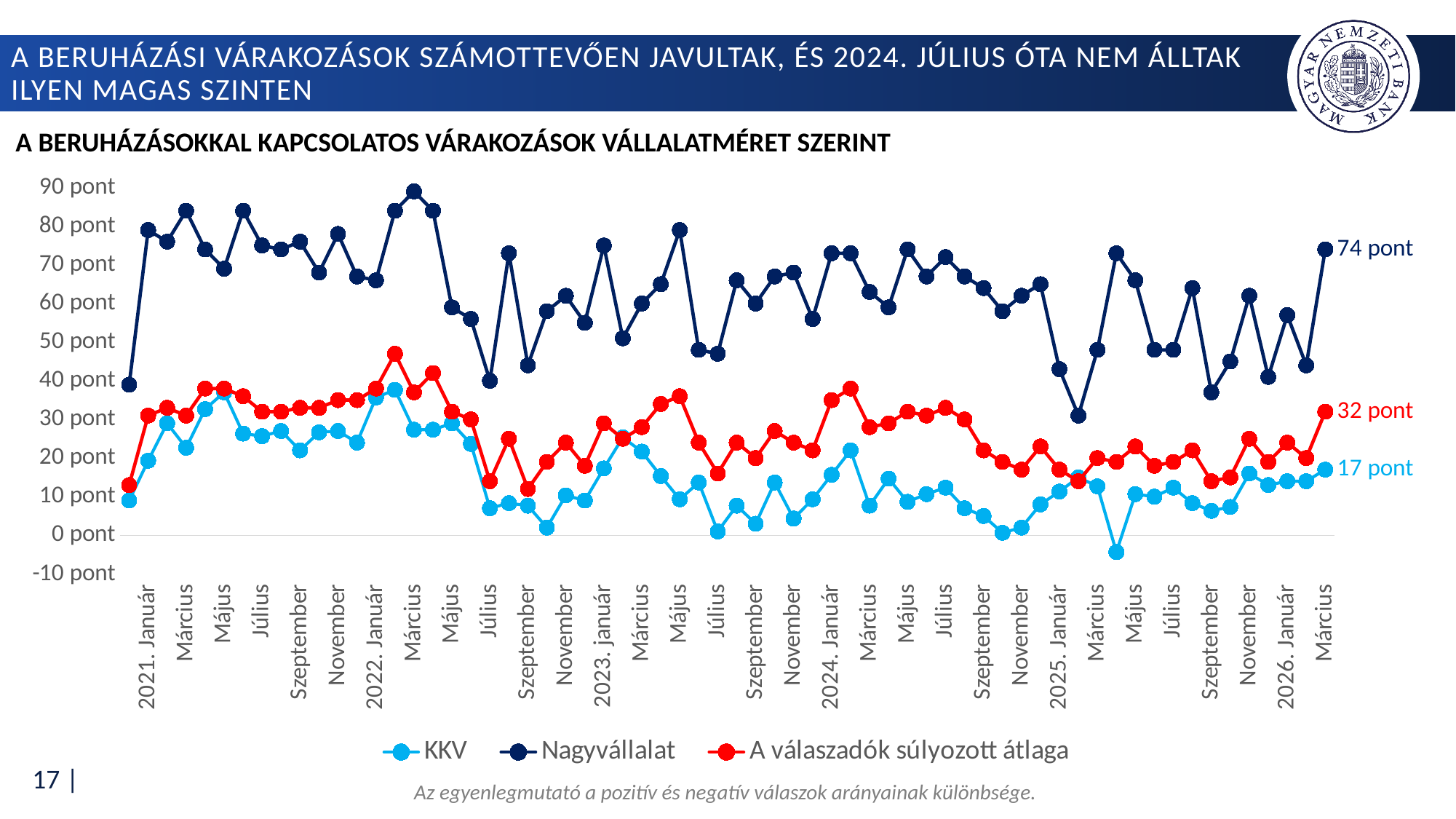
Is the value for Nagyvállalat at 2021. Január greater or less than 50 pont? greater What is the difference between the Nagyvállalat value and the weighted average ('A válaszadók súlyozott átlaga') at the last point (2026 Március)? 42 pont What is the value of the KKV series at the last point (2026 Március)? 17 pont Which series has the lowest value at the last point (2026 Március)? KKV What is the value of the Nagyvállalat series at the last point (2026 Március)? 74 pont Which series has the highest value at the last point (2026 Március)? Nagyvállalat What is the value of 'A válaszadók súlyozott átlaga' at the last point (2026 Március)? 32 pont What is the title of the chart? A beruházásokkal kapcsolatos várakozások vállalatméret szerint What is the difference between the Nagyvállalat and KKV values at the last point (2026 Március)? 57 pont Is the value for KKV at 2025 Május greater or less than 0 pont? greater How many series does the legend list? 3 What kind of chart is shown on the slide? Line chart